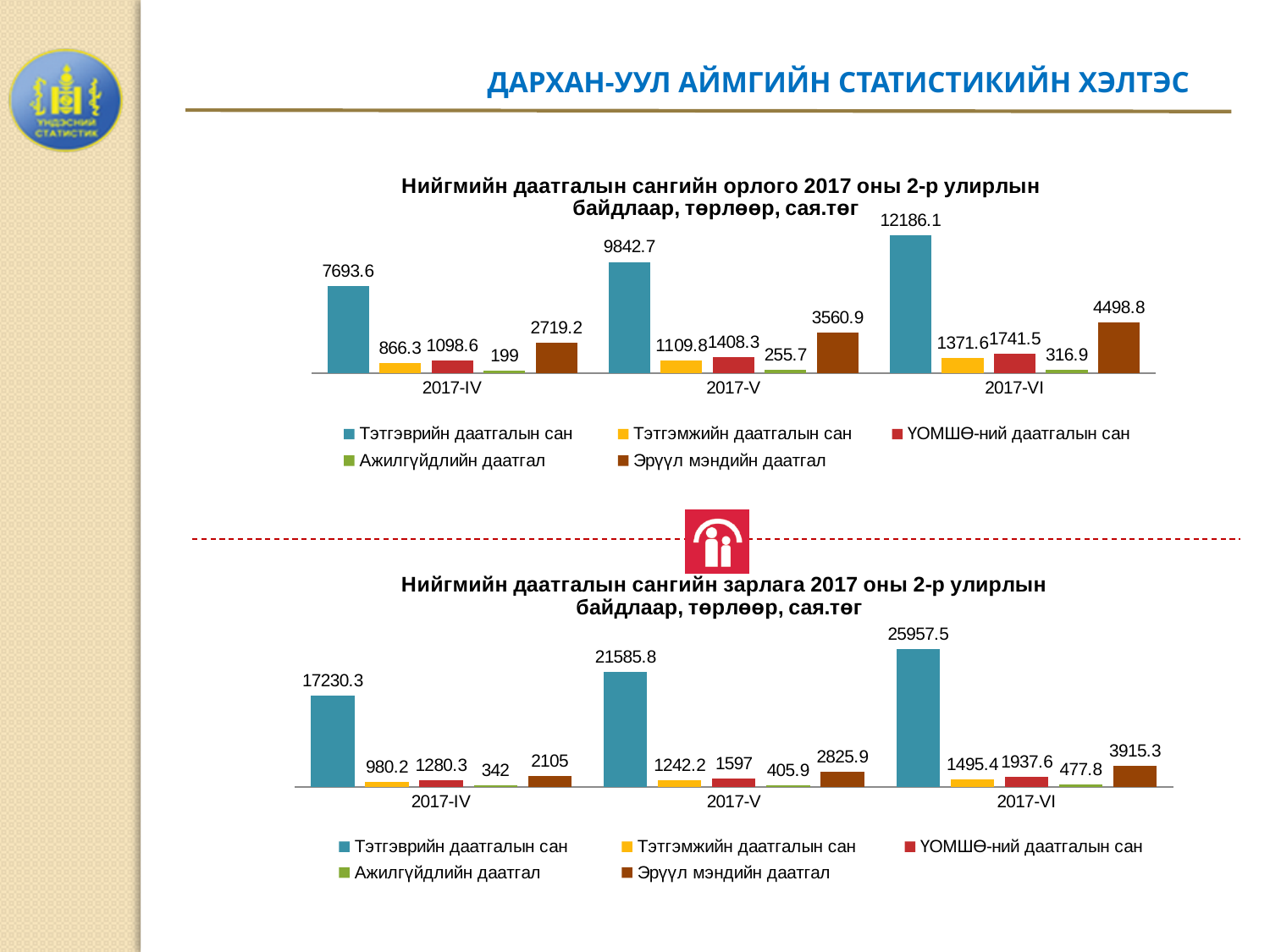
In the bottom chart (Нийгмийн даатгалын сангийн зарлага), which is larger: Эрүүл мэндийн даатгал in 2017-VI or ҮОМШӨ-ний даатгалын сан in 2017-VI? Эрүүл мэндийн даатгал in 2017-VI In the top chart (Нийгмийн даатгалын сангийн орлого), which period has the highest value for Тэтгэврийн даатгалын сан? 2017-VI In the top chart (Нийгмийн даатгалын сангийн орлого), what is the value of Эрүүл мэндийн даатгал for 2017-IV? 2719.2 What type of chart is the bottom chart (Нийгмийн даатгалын сангийн зарлага)? Bar chart In the bottom chart (Нийгмийн даатгалын сангийн зарлага), which series has the lowest value in 2017-IV? Ажилгүйдлийн даатгал In the bottom chart (Нийгмийн даатгалын сангийн зарлага), what is the value of ҮОМШӨ-ний даатгалын сан for 2017-VI? 1937.6 How many series does the legend of the bottom chart (Нийгмийн даатгалын сангийн зарлага) list? 5 In the bottom chart (Нийгмийн даатгалын сангийн зарлага), what is the value of Ажилгүйдлийн даатгал for 2017-V? 405.9 In the bottom chart (Нийгмийн даатгалын сангийн зарлага), does the value of Тэтгэврийн даатгалын сан rise or fall from 2017-IV to 2017-VI? Rise In the top chart (Нийгмийн даатгалын сангийн орлого), what is the difference between Тэтгэврийн даатгалын сан in 2017-V and 2017-IV? 2149.1 How many periods are shown on the x axis of the top chart (Нийгмийн даатгалын сангийн орлого)? 3 In the top chart (Нийгмийн даатгалын сангийн орлого), what is the value of Тэтгэврийн даатгалын сан for 2017-VI? 12186.1